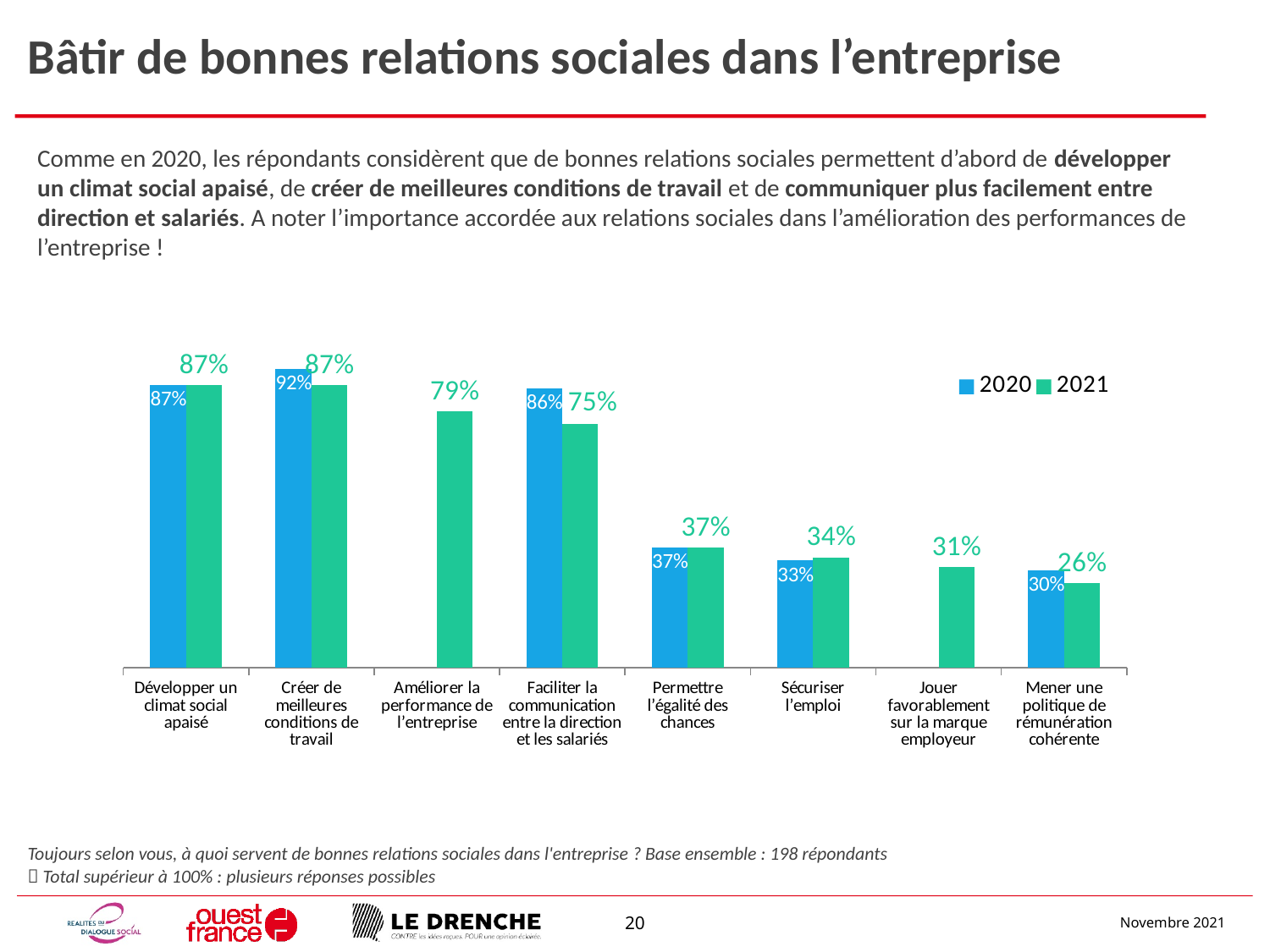
Which category has the highest 2020 value? Créer de meilleures conditions de travail What is the 2020 value for "Sécuriser l'emploi"? 33% What is the difference between the 2020 and 2021 values for "Faciliter la communication entre la direction et les salariés"? 11 percentage points What is the 2020 value for "Créer de meilleures conditions de travail"? 92% What kind of chart is shown on the slide? Bar chart How many categories are shown on the x axis? 8 How many series does the legend list? 2 What is the 2021 value for "Améliorer la performance de l'entreprise"? 79% What is the 2021 value for "Mener une politique de rémunération cohérente"? 26% Which series is shown in green in the legend? 2021 Which category has the lowest 2021 value? Mener une politique de rémunération cohérente For "Créer de meilleures conditions de travail", which is larger: the 2020 value or the 2021 value? 2020